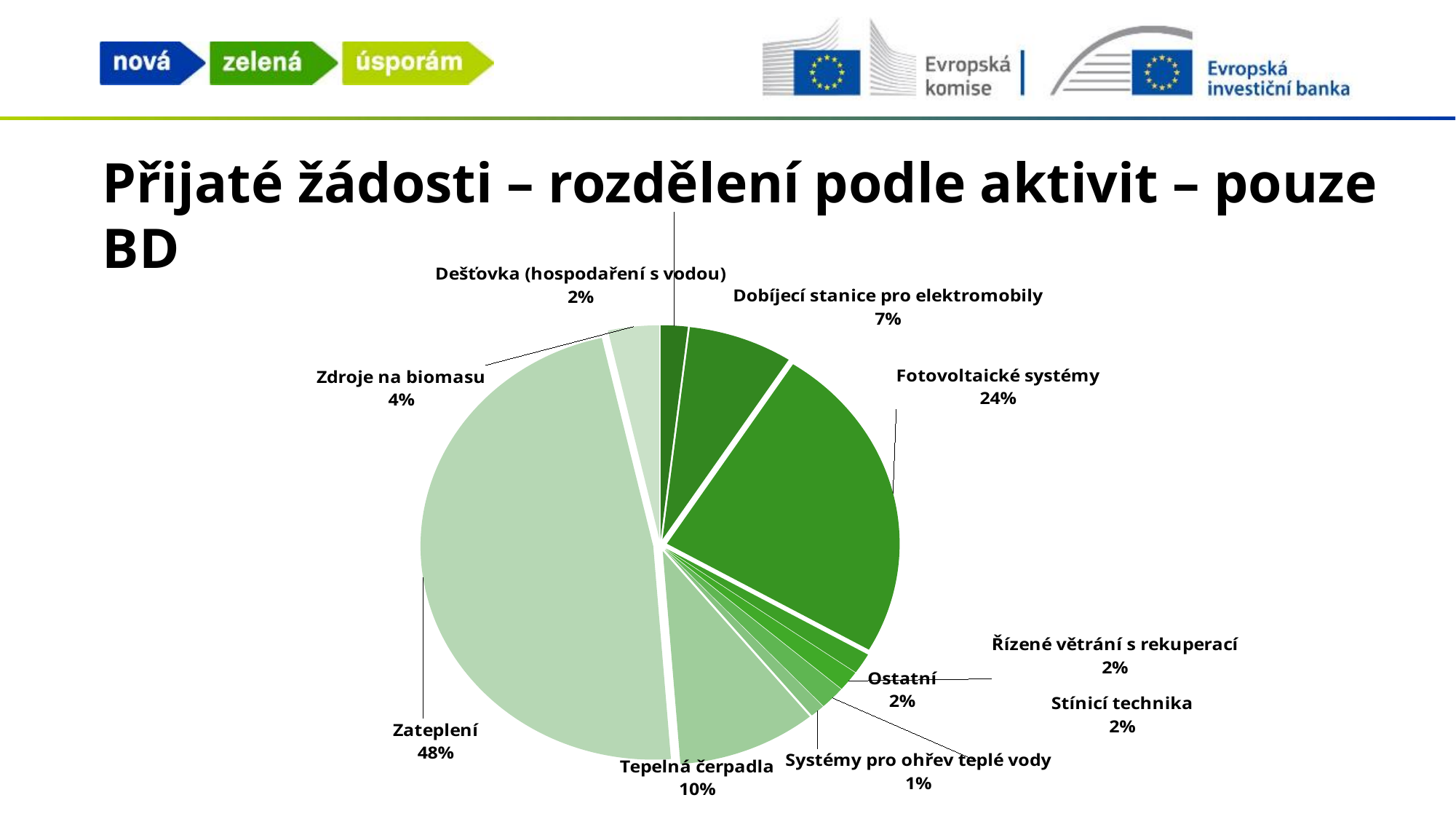
What is the difference in percentage points between Zateplení and Fotovoltaické systémy? 24 What is the value shown for Zdroje na biomasu? 4% Which is larger, the slice for Tepelná čerpadla or the slice for Dobíjecí stanice pro elektromobily? Tepelná čerpadla What share of the pie does Zateplení have? 48% Which category has the smallest slice of the pie? Systémy pro ohřev teplé vody What is the title of the slide containing the pie chart? Přijaté žádosti – rozdělení podle aktivit – pouze BD Which category has the largest slice of the pie? Zateplení What type of chart is shown on the slide? pie chart What share of the pie does Fotovoltaické systémy have? 24% What is the value shown for Dobíjecí stanice pro elektromobily? 7% What is the value shown for Tepelná čerpadla? 10% How many categories are shown in the pie chart? 10